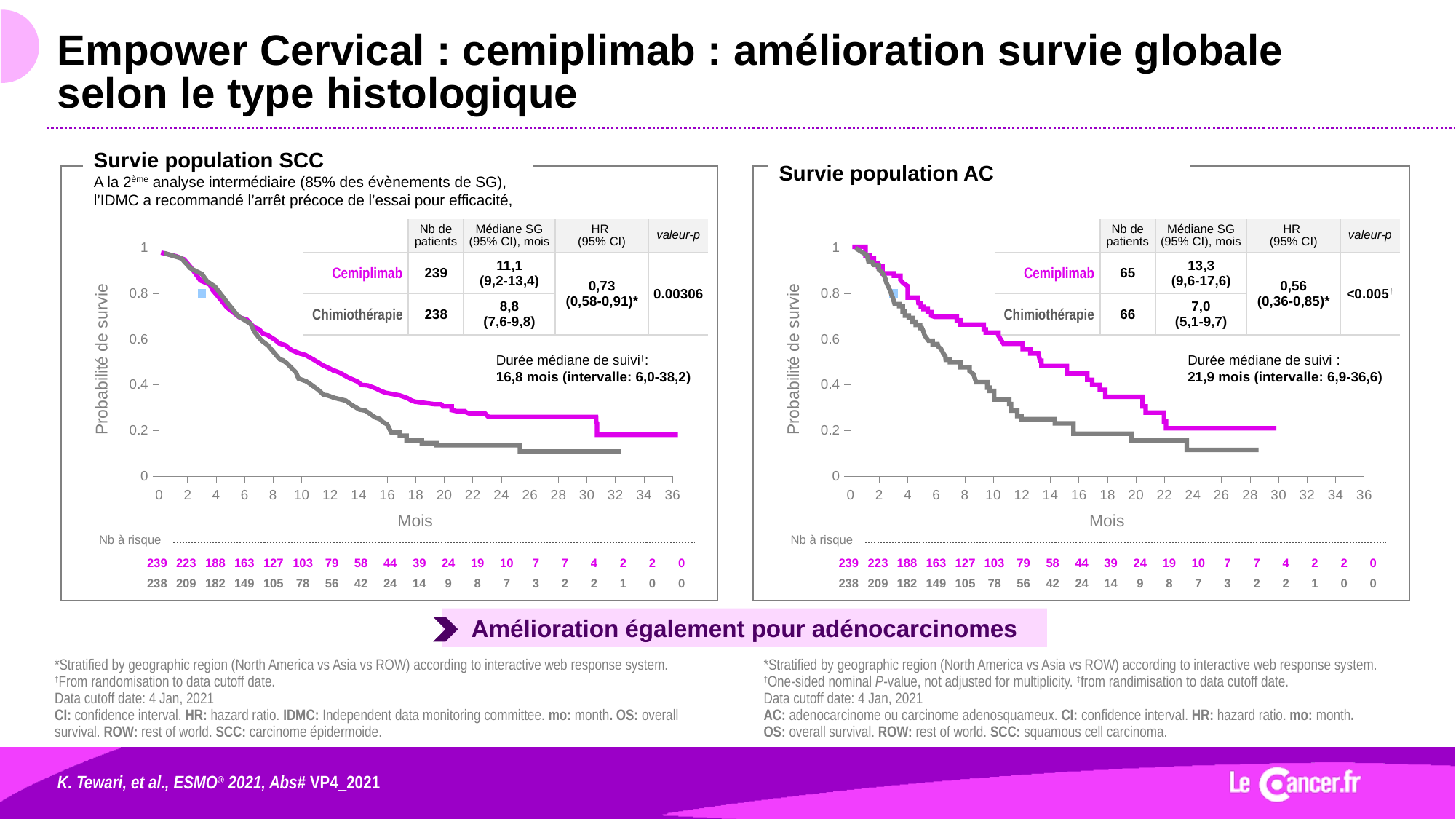
In the 'Survie population AC' chart table, what is the median SG (months) for Chimiothérapie? 7,0 (5,1-9,7) In the 'Survie population SCC' chart, which group has the higher median SG, Cemiplimab or Chimiothérapie? Cemiplimab In the 'Survie population SCC' chart, what is the HR (95% CI)? 0,73 (0,58-0,91)* In the 'Survie population SCC' chart, is the survival probability of the Chimiothérapie curve at 30 months greater or less than 0.2? less In the 'Survie population SCC' chart table, what is the median SG (months) for Cemiplimab? 11,1 (9,2-13,4) What kind of chart is shown under 'Survie population SCC'? Line chart (Kaplan-Meier survival curve) In the 'Survie population AC' chart, what is the valeur-p shown? <0.005 What is the median follow-up duration stated in the 'Survie population AC' chart? 21,9 mois (intervalle: 6,9-36,6) In the 'Survie population AC' chart, is the survival probability of the Cemiplimab curve at 12 months greater or less than 0.4? greater In the 'Survie population SCC' chart, do the survival curves rise or fall as months increase? fall In the 'Survie population SCC' chart table, how many patients are in the Chimiothérapie group? 238 In the 'Survie population AC' chart, what is the difference between the median SG of Cemiplimab (13,3) and Chimiothérapie (7,0), in months? 6,3